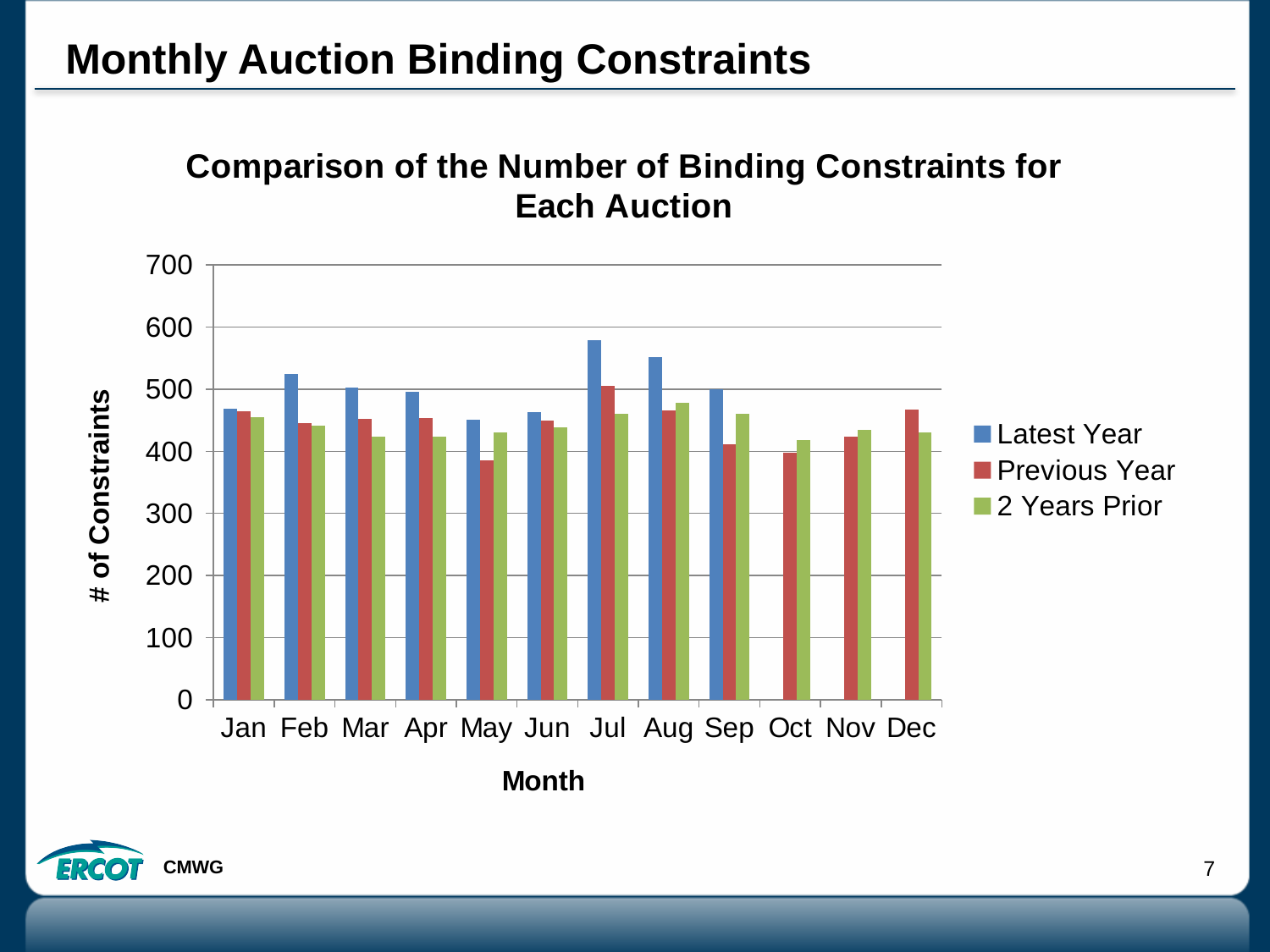
How many months are shown on the x axis? 12 In which month is the Previous Year value highest? Jul How many months have a Latest Year bar? 9 Is the Latest Year value for Jul greater or less than 500? greater Is the Latest Year value for Feb greater or less than 500? greater What kind of chart is shown on the slide? bar chart In which month is the Previous Year value lowest? May How many series does the legend list? 3 Is the Previous Year value for May greater or less than 400? less For Feb, which is larger: the Latest Year value or the Previous Year value? Latest Year In which month is the Latest Year value highest? Jul What is the title of the y axis? # of Constraints